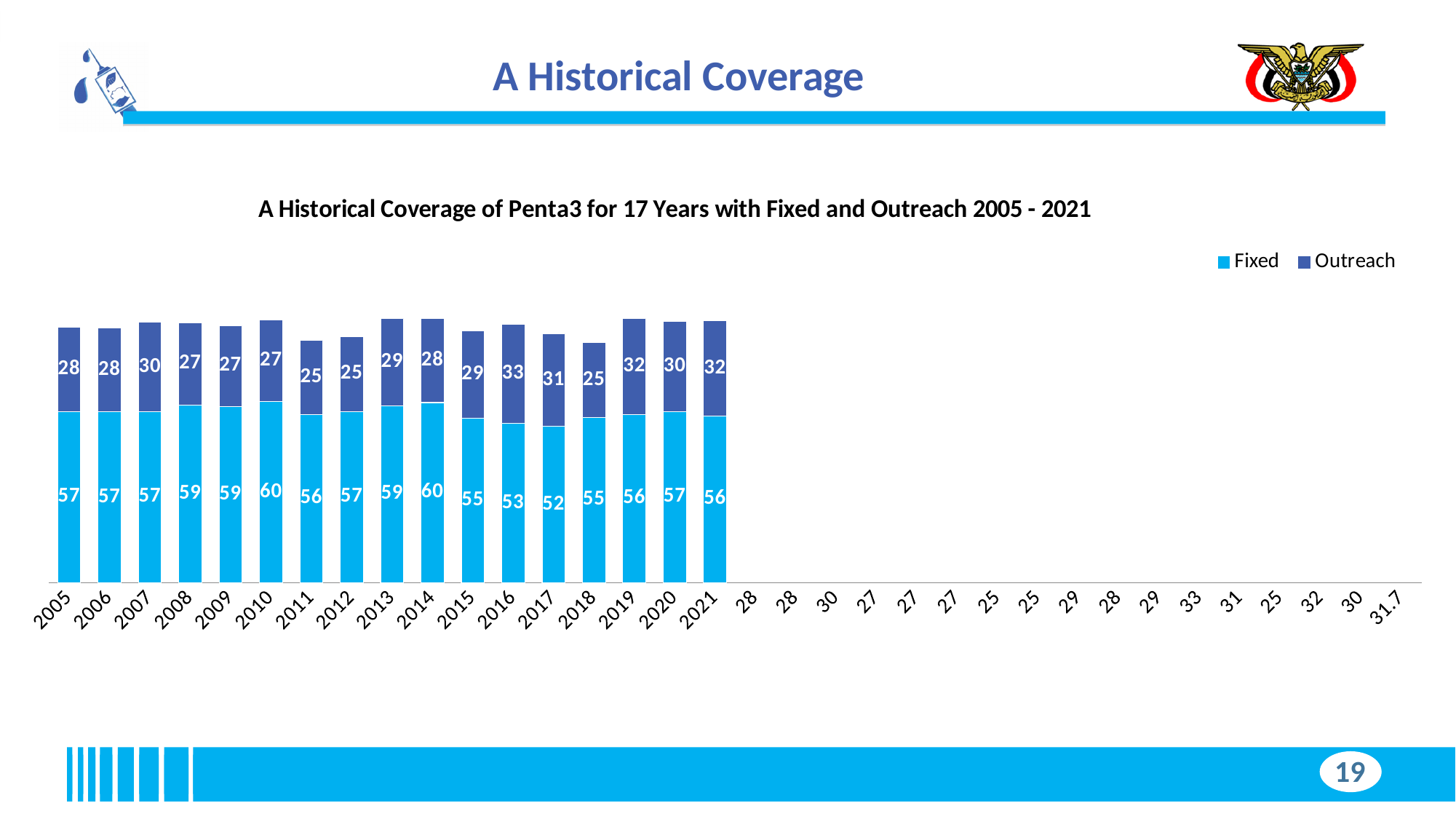
Which year has the lowest Fixed value? 2017 What is the difference between the Fixed values for 2014 and 2017? 8 What is the Outreach value for 2021? 32 Which year has the highest Outreach value? 2016 What is the Fixed value for 2017? 52 How many series does the legend list? 2 What kind of chart is shown on the slide? Stacked bar chart What is the Fixed value for 2010? 60 What is the Outreach value for 2016? 33 What is the total of the stacked bar for 2021 (Fixed plus Outreach)? 88 How many years are plotted as bars in the chart? 17 Which is larger, the Outreach value for 2019 or the Outreach value for 2018? 2019